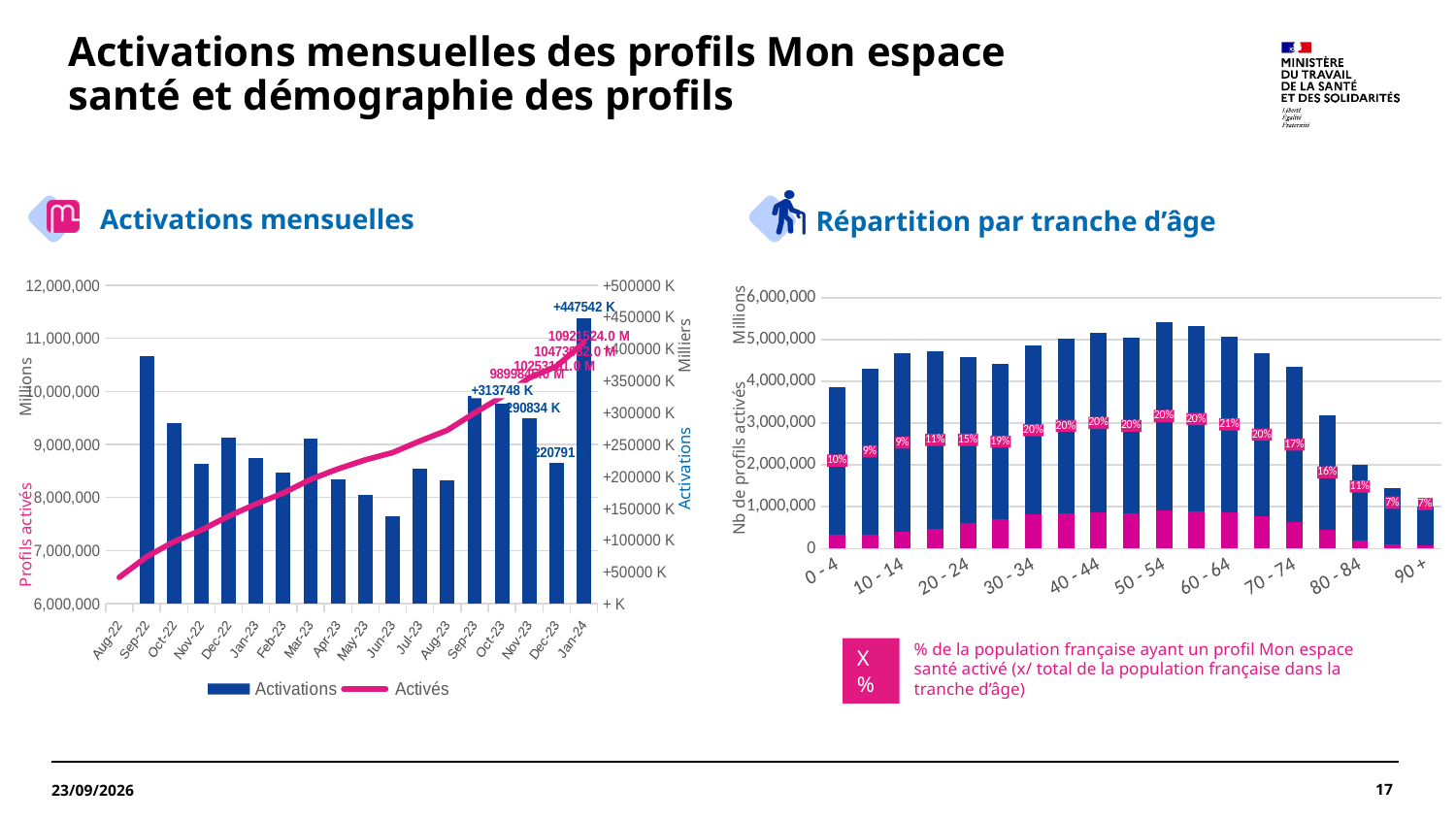
In the 'Activations mensuelles' chart, what are the two legend entries? Activations and Activés In the 'Activations mensuelles' chart, how many months are shown on the x axis? 18 In the 'Activations mensuelles' chart, does the Activés line rise or fall from Aug-22 to Jan-24? rise In the 'Répartition par tranche d'âge' chart, which age group has the highest percentage label? 60 - 64 (21%) In the 'Répartition par tranche d'âge' chart, what percentage is shown for the 90 + age group? 7% What kind of chart is 'Répartition par tranche d'âge'? stacked bar chart In the 'Activations mensuelles' chart, which month has the lowest Activations bar? Jun-23 In the 'Répartition par tranche d'âge' chart, what percentage is shown for the 0 - 4 age group? 10% In the 'Activations mensuelles' chart, which month has the highest Activations bar? Jan-24 In the 'Activations mensuelles' chart, how many series does the legend list? 2 In the 'Répartition par tranche d'âge' chart, is the total bar for the 0 - 4 age group greater or less than 4,000,000? less